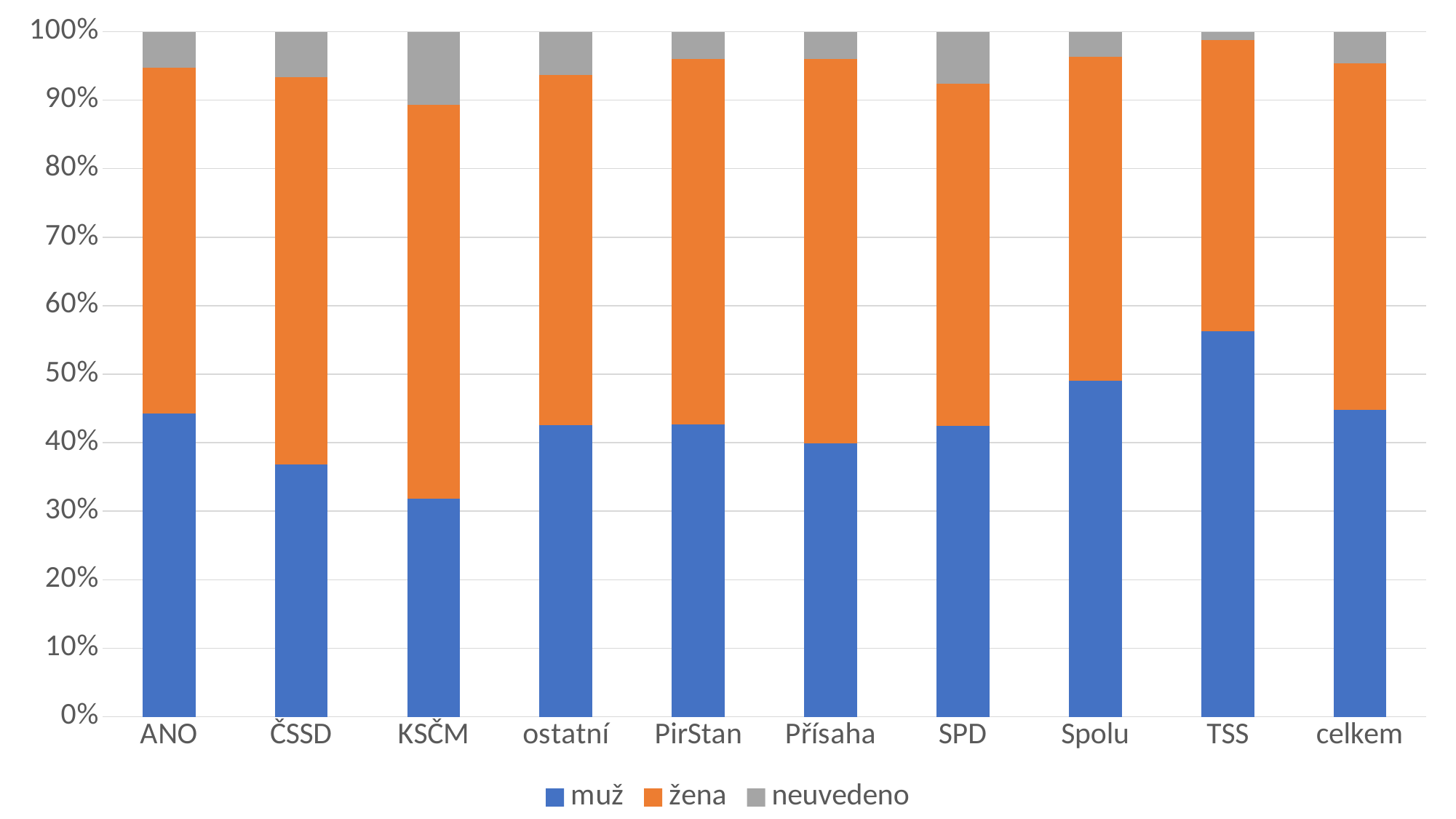
How many categories are shown along the x axis? 10 Is the muž share for KSČM greater or less than 40%? less Which category has the largest share for the series neuvedeno? KSČM Is the muž share for TSS greater or less than 50%? greater Which category has the highest share for the series muž? TSS What are the three legend entries of the chart? muž, žena, neuvedeno How many series does the legend list? 3 What kind of chart is shown on the slide? Stacked bar chart What is the total height of the stacked bar for ANO? 100% Which has a larger muž share, Spolu or ANO? Spolu Which category has the smallest share for the series neuvedeno? TSS Which category has the lowest share for the series muž? KSČM